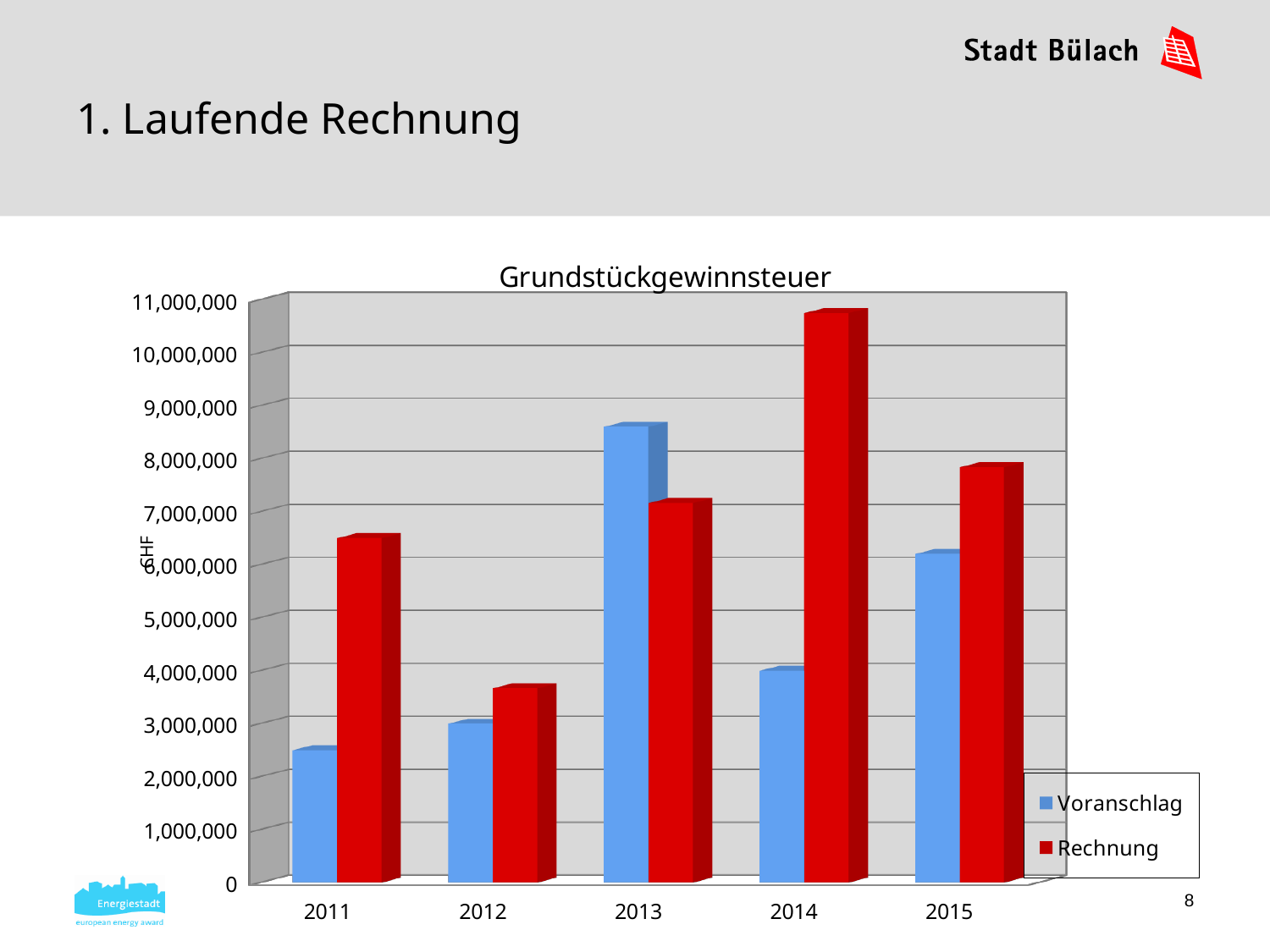
In which year is the Voranschlag value highest? 2013 In 2014, which is larger: Voranschlag or Rechnung? Rechnung In 2013, which is larger: Voranschlag or Rechnung? Voranschlag Is the Voranschlag value for 2011 greater or less than 3,000,000? less In which year is the Voranschlag value lowest? 2011 Is the Rechnung value for 2014 greater or less than 10,000,000? greater How many series does the legend of the Grundstückgewinnsteuer chart list? 2 How many years are shown on the x axis of the Grundstückgewinnsteuer chart? 5 What kind of chart is shown on the slide? bar chart In which year is the Rechnung value lowest? 2012 In which year is the Rechnung value highest? 2014 What is the title of the chart? Grundstückgewinnsteuer